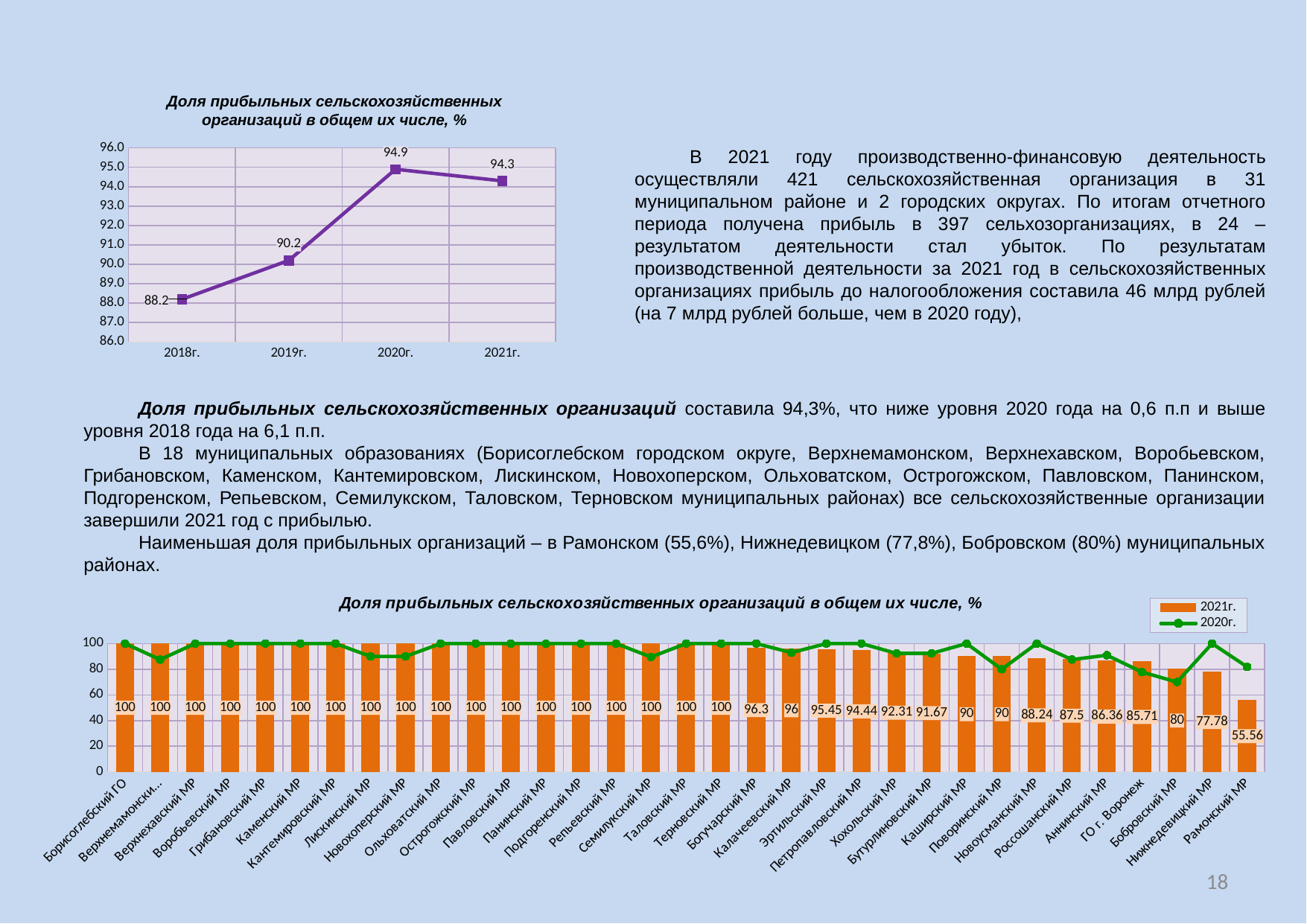
In the top line chart, which year has the lowest value? 2018г. In the top line chart, which year has the highest value? 2020г. In the top line chart, did the value rise or fall from 2020 to 2021? fall In the top line chart, what was the share of profitable agricultural organizations in 2018? 88.2 In the bottom bar chart, is the 2021 value for Нижнедевицкий МР greater or less than the 2021 value for Бобровский МР? less In the bottom bar chart, what is the 2021 value for Богучарский МР? 96.3 In the bottom bar chart, what is the 2021 value for Рамонский МР? 55.56 In the top line chart, what value is shown for 2020? 94.9 In the bottom bar chart, how many series does the legend list? 2 In the top line chart, how many years are plotted? 4 In the top line chart, what is the difference between the 2021 value and the 2018 value? 6.1 In the bottom bar chart, which municipality has the lowest 2021 value? Рамонский МР